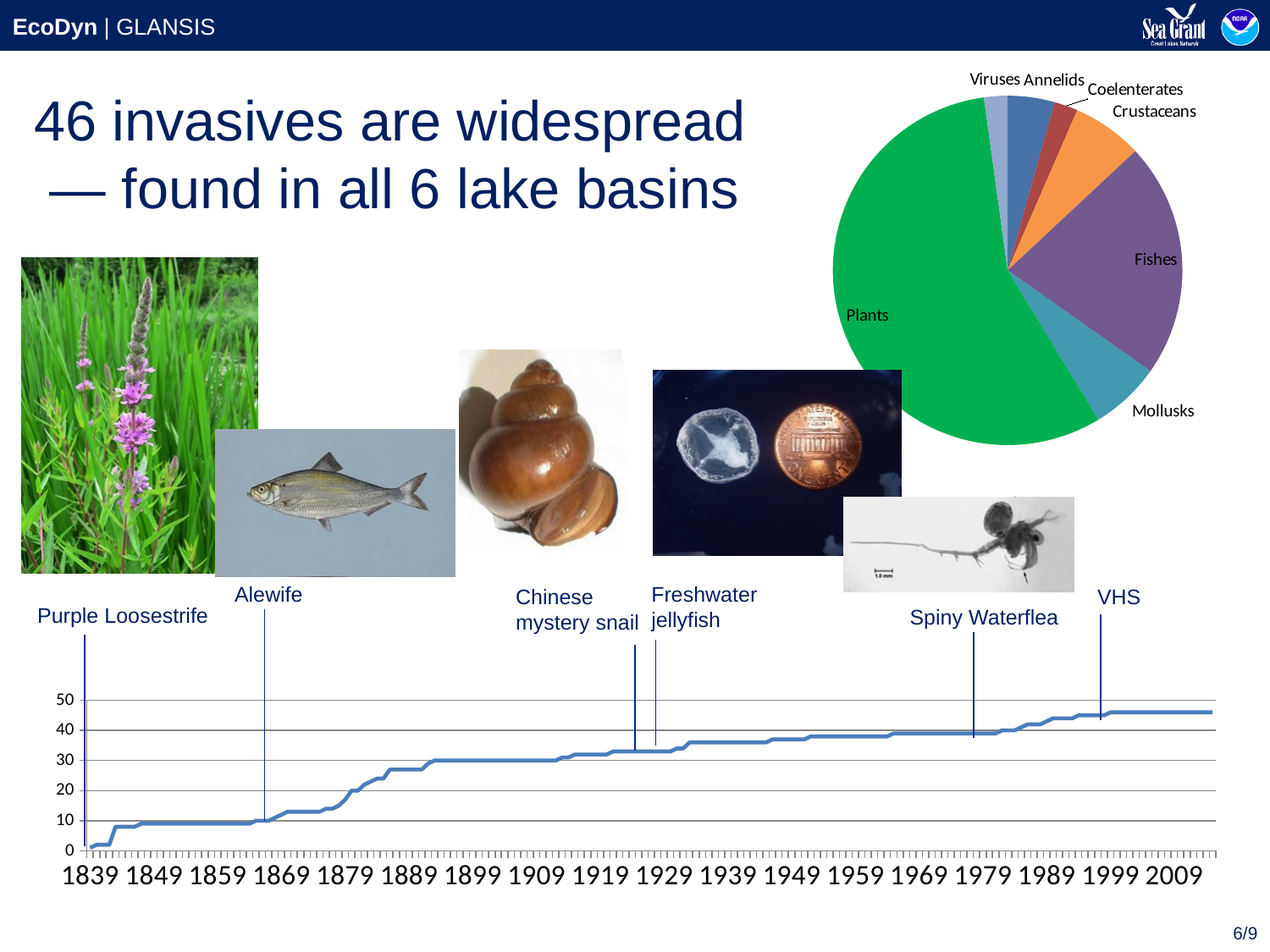
In the line chart at the bottom, is the value for 1949 greater or less than 30? greater In the pie chart, which slice is larger, Crustaceans or Coelenterates? Crustaceans In the line chart at the bottom, which species is annotated at the earliest year? Purple Loosestrife What kind of chart is the chart at the bottom of the slide? line chart In the pie chart, which slice is larger, Plants or Fishes? Plants In the pie chart, which slice is larger, Fishes or Mollusks? Fishes In the line chart at the bottom, do the values rise or fall from 1839 to 2009? rise What kind of chart is the chart in the top right of the slide? pie chart In the line chart at the bottom, is the value for 1849 greater or less than 20? less In the line chart at the bottom, which species is annotated at the latest year? VHS In the line chart at the bottom, is the value for 2009 greater or less than 40? greater In the pie chart, which category has the largest slice? Plants